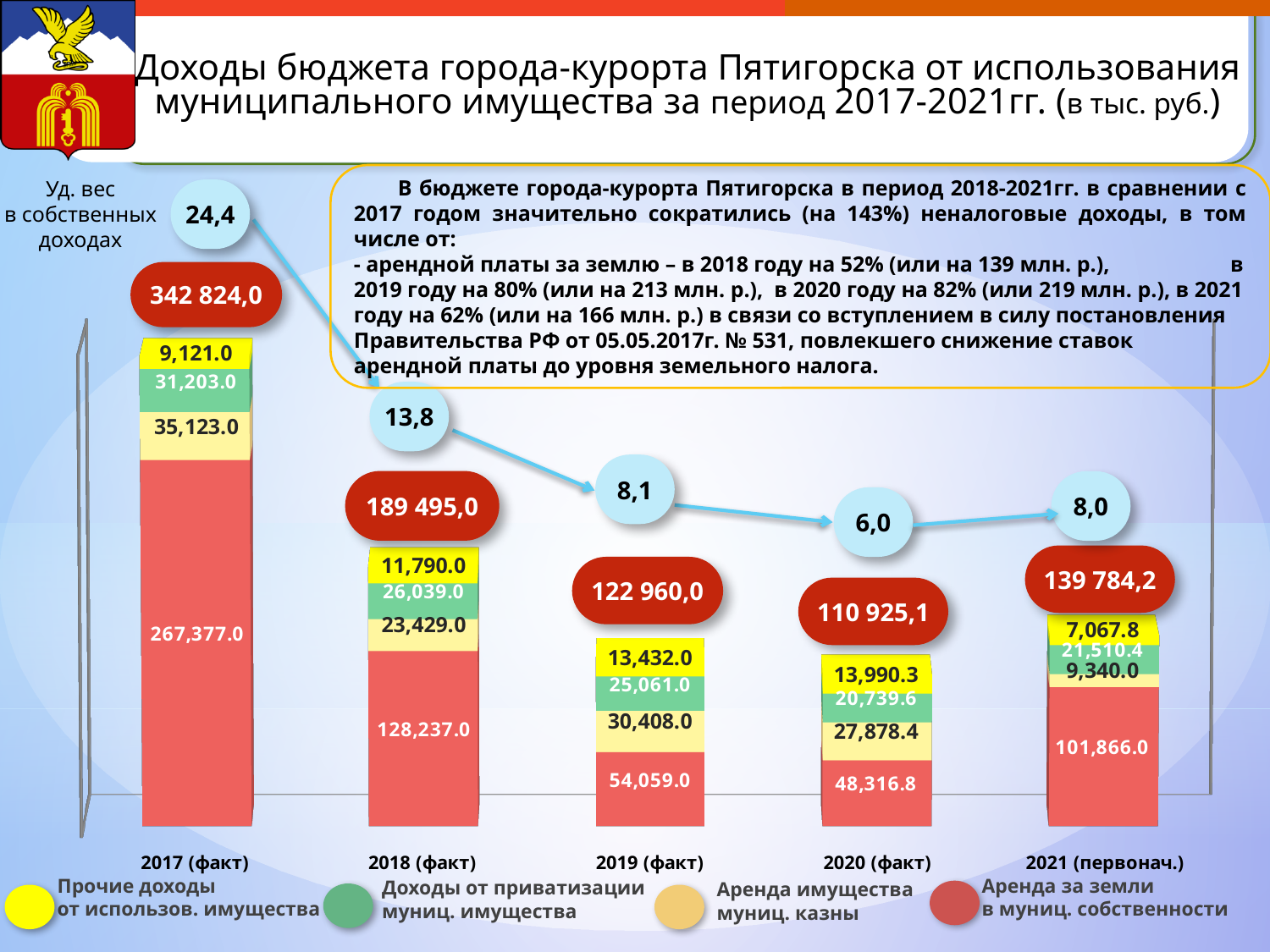
How many year categories are shown along the x axis of the chart? 5 Which year has the lowest total income from use of municipal property? 2020 (факт) Which year has the highest total income from use of municipal property? 2017 (факт) What colour represents 'Прочие доходы от использов. имущества' in the legend? yellow What is the total shown for the 2019 (факт) bar? 122 960,0 What is the value of 'Аренда за земли в муниц. собственности' for 2017 (факт)? 267,377.0 What is the value of 'Доходы от приватизации муниц. имущества' for 2020 (факт)? 20,739.6 Which is larger: 'Аренда за земли в муниц. собственности' in 2018 (факт) or in 2021 (первонач.)? 2018 (факт) How many series does the legend list? 4 What is the difference between the 'Аренда имущества муниц. казны' values for 2019 (факт) and 2021 (первонач.)? 21,068.0 What is the value of 'Прочие доходы от использов. имущества' for 2021 (первонач.)? 7,067.8 What type of chart is shown on the slide? stacked bar chart